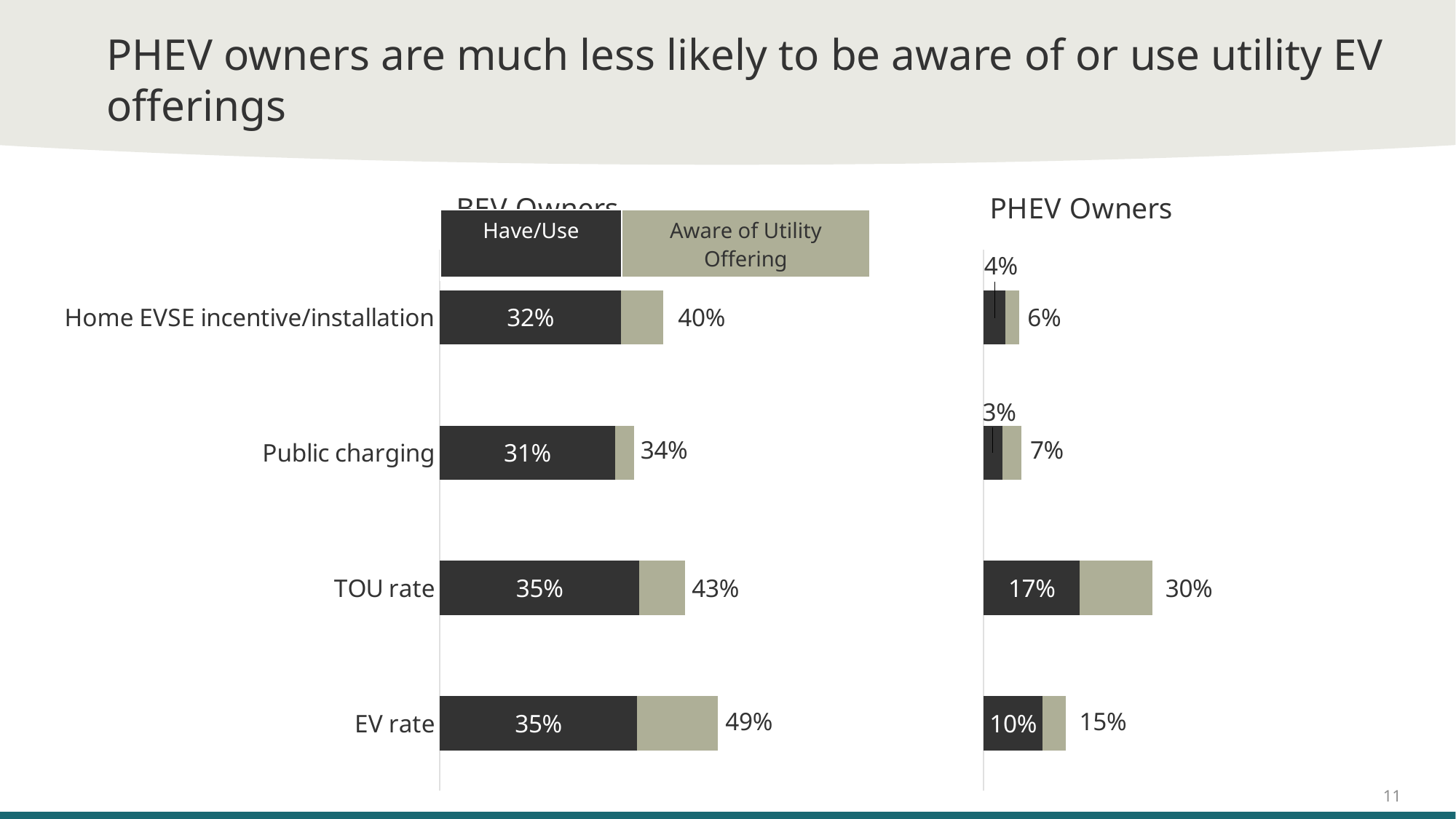
In the BEV Owners chart, which category has the highest Aware of Utility Offering value? EV rate In the PHEV Owners chart, what is the Have/Use value for TOU rate? 17% In the PHEV Owners chart, what is the difference between the Aware of Utility Offering value and the Have/Use value for TOU rate? 13% In the BEV Owners chart, what is the Aware of Utility Offering value for EV rate? 49% What is the difference between the BEV Owners and PHEV Owners Have/Use values for EV rate? 25% How many categories are shown in the BEV Owners chart? 4 How many series does the legend list? 2 In the PHEV Owners chart, which category has the lowest Have/Use value? Public charging In the PHEV Owners chart, what is the Aware of Utility Offering value for Public charging? 7% In the BEV Owners chart, what is the Have/Use value for Home EVSE incentive/installation? 32% What type of chart is the PHEV Owners chart? Bar chart Which is larger: the Aware of Utility Offering value for TOU rate in the BEV Owners chart or in the PHEV Owners chart? BEV Owners